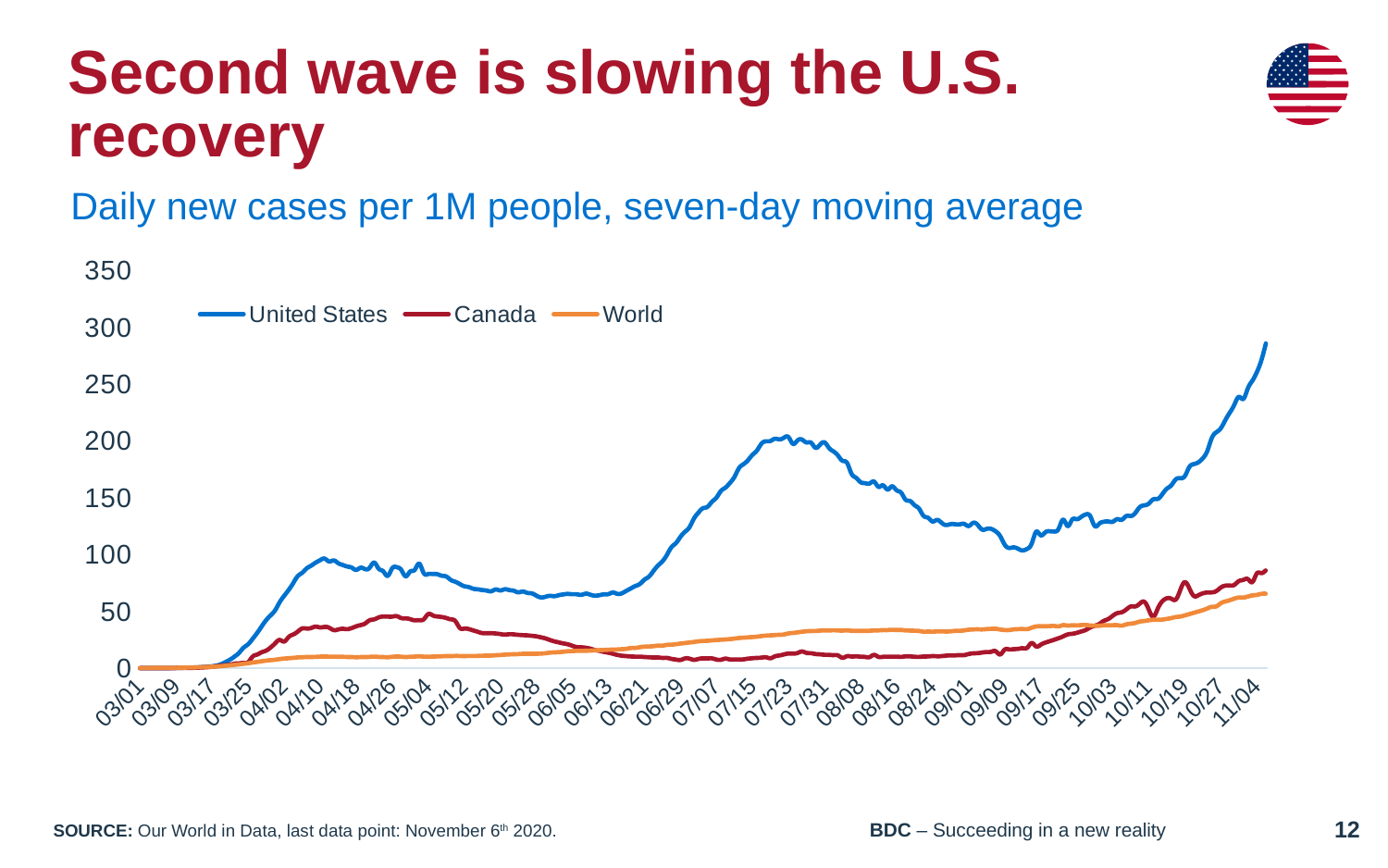
Which series has the highest value at 11/04? United States What is the subtitle describing the measure plotted in the chart? Daily new cases per 1M people, seven-day moving average Does the United States line rise or fall between 09/09 and 11/04? rise What kind of chart is shown on the slide? Line chart Is the value for Canada at 11/04 greater or less than 50? greater How many series does the legend list? 3 Is the value for United States at 11/04 greater or less than 250? greater Which series has the lowest value at 11/04? World Is the value for World at 11/04 greater or less than 100? less Which is larger at 08/16, the value for Canada or the value for World? World Which series are listed in the legend? United States, Canada, World Does the Canada line rise or fall between 04/26 and 08/16? fall